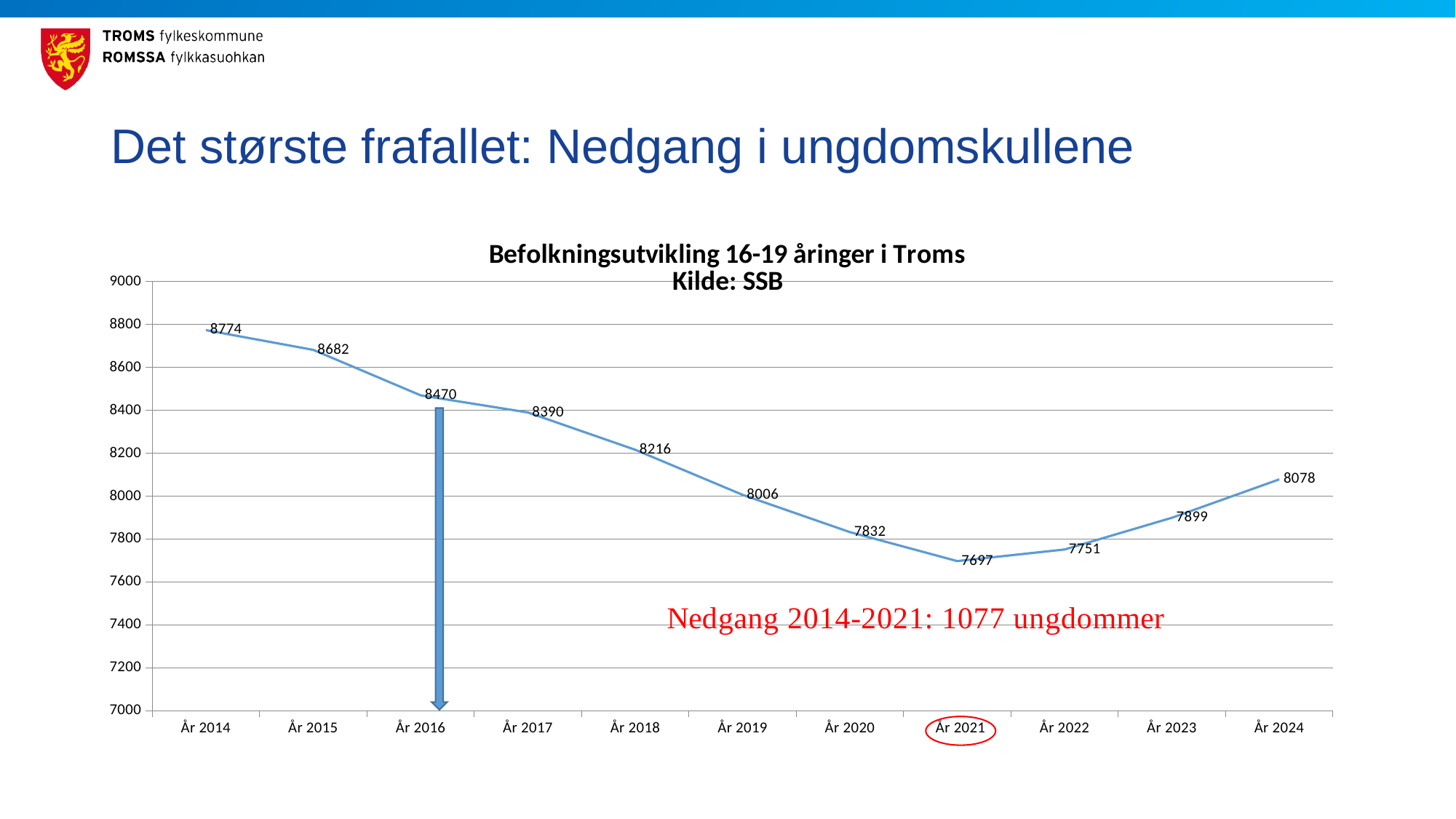
How many years are plotted on the x axis? 11 What is the value for År 2024? 8078 Which year has the lowest value? År 2021 Do the values rise or fall from År 2014 to År 2021? fall What is the value for År 2014? 8774 Which is larger, the value for År 2016 or the value for År 2023? År 2016 What kind of chart is shown? line chart What is the value for År 2021? 7697 What is the difference between the values for År 2014 and År 2021? 1077 Is the value for År 2019 greater or less than 8200? less Which year has the highest value? År 2014 What is the title of the chart? Befolkningsutvikling 16-19 åringer i Troms Kilde: SSB